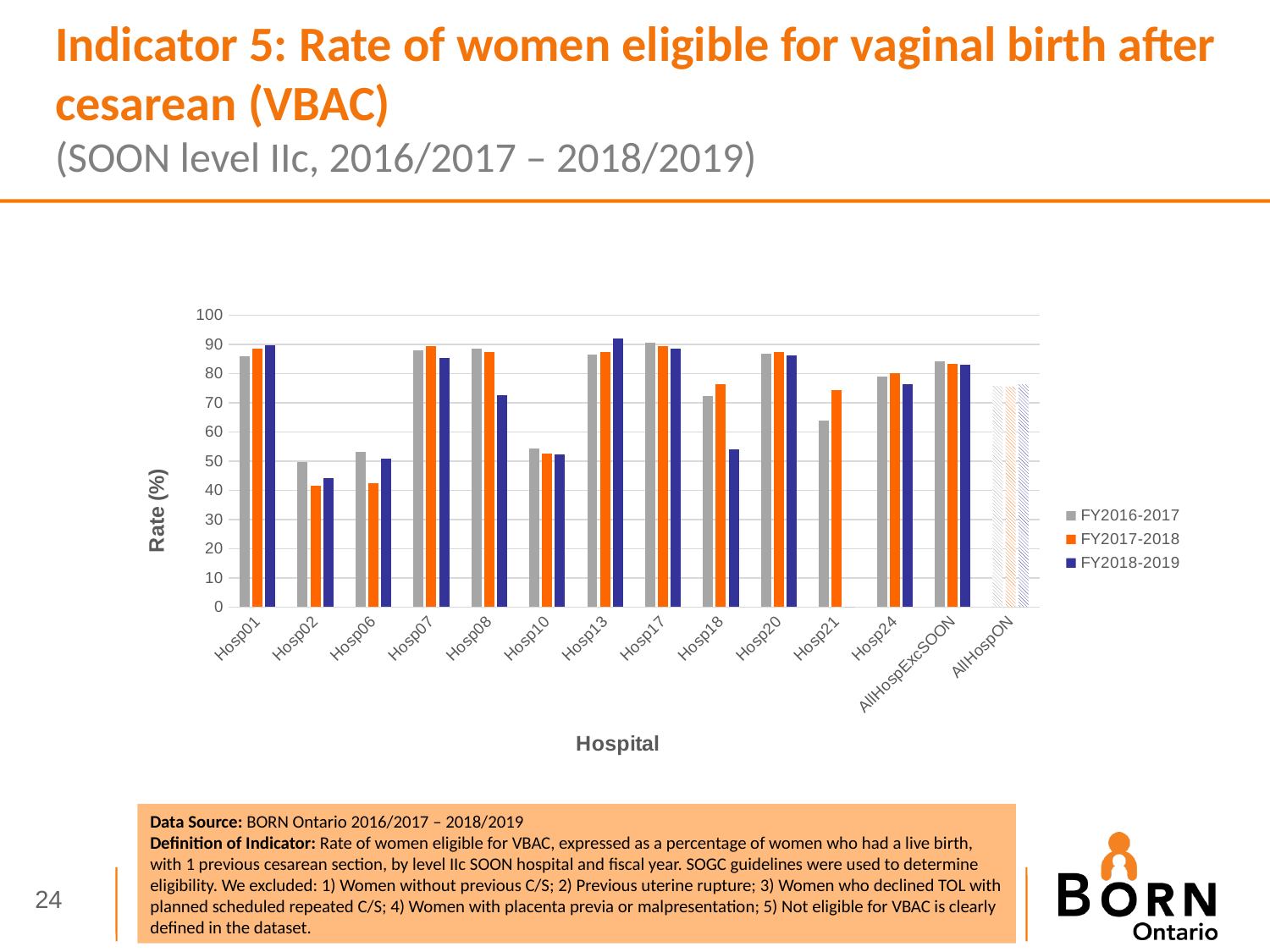
Is the FY2017-2018 value for Hosp20 greater or less than 80? greater Is the FY2018-2019 value for Hosp08 greater or less than 80? less Is the FY2018-2019 value for Hosp18 greater or less than 60? less For Hosp21, which is larger: the FY2016-2017 value or the FY2017-2018 value? FY2017-2018 How many hospital categories are shown on the x axis? 14 How many series does the legend list? 3 What kind of chart is shown on the slide? Bar chart For Hosp18, which is larger: the FY2017-2018 value or the FY2018-2019 value? FY2017-2018 Which hospital category has no FY2018-2019 bar plotted? Hosp21 What is the title of the y axis? Rate (%)